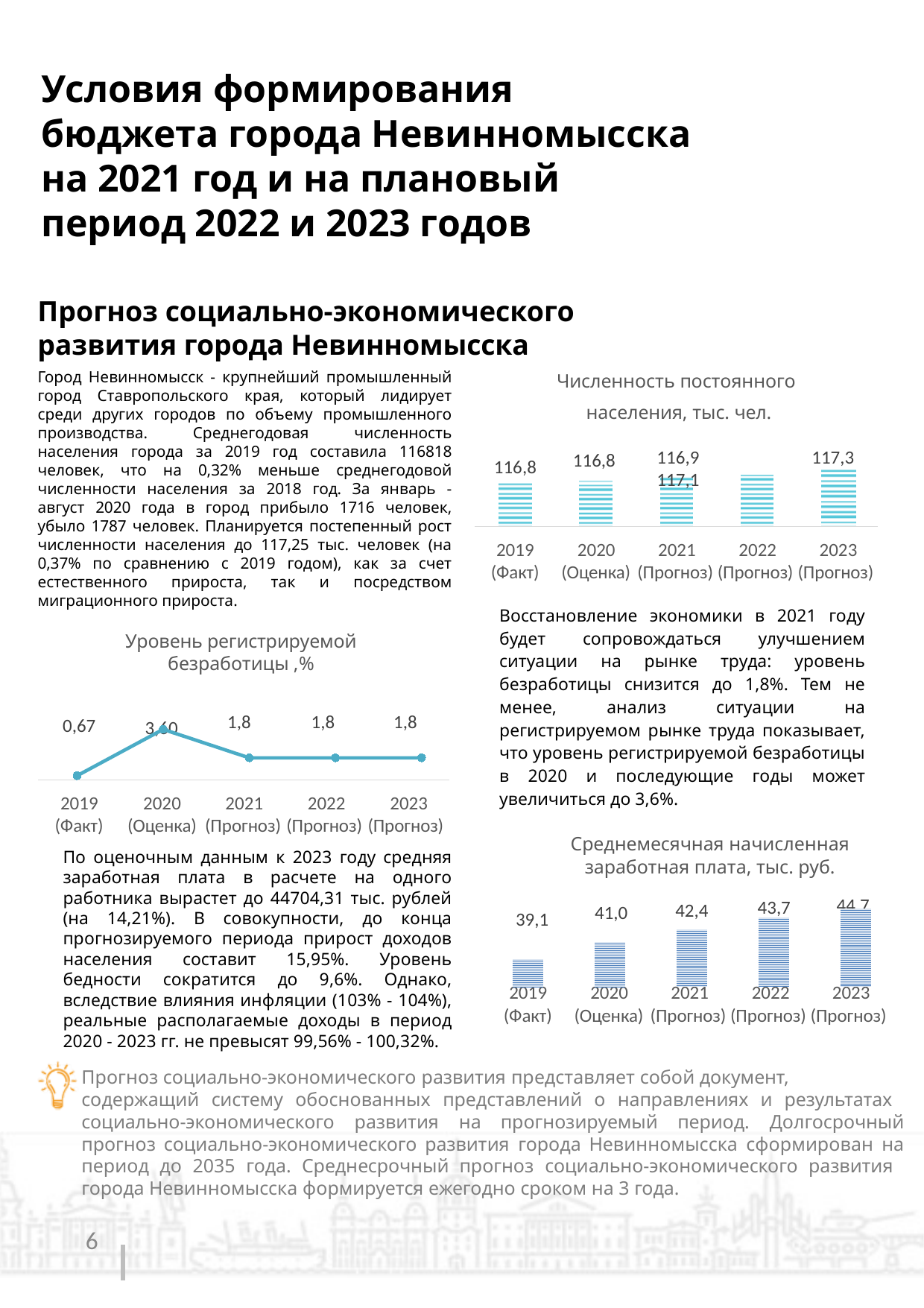
In the chart 'Численность постоянного населения, тыс. чел.', what is the value for 2023 (Прогноз)? 117,3 In the chart 'Уровень регистрируемой безработицы ,%', what is the value for 2019 (Факт)? 0,67 In the chart 'Среднемесячная начисленная заработная плата, тыс. руб.', what is the value for 2021 (Прогноз)? 42,4 In the chart 'Уровень регистрируемой безработицы ,%', what is the value for 2021 (Прогноз)? 1,8 What kind of chart is 'Уровень регистрируемой безработицы ,%'? line chart In the chart 'Численность постоянного населения, тыс. чел.', how many years are shown on the x axis? 5 In the chart 'Уровень регистрируемой безработицы ,%', which year has the highest value? 2020 (Оценка) What kind of chart is 'Среднемесячная начисленная заработная плата, тыс. руб.'? bar chart In the chart 'Численность постоянного населения, тыс. чел.', what is the value for 2019 (Факт)? 116,8 In the chart 'Численность постоянного населения, тыс. чел.', which year has the highest value? 2023 (Прогноз) In the chart 'Среднемесячная начисленная заработная плата, тыс. руб.', do the values rise or fall from 2019 to 2023? rise In the chart 'Среднемесячная начисленная заработная плата, тыс. руб.', what is the difference between the 2023 and 2019 values? 5,6